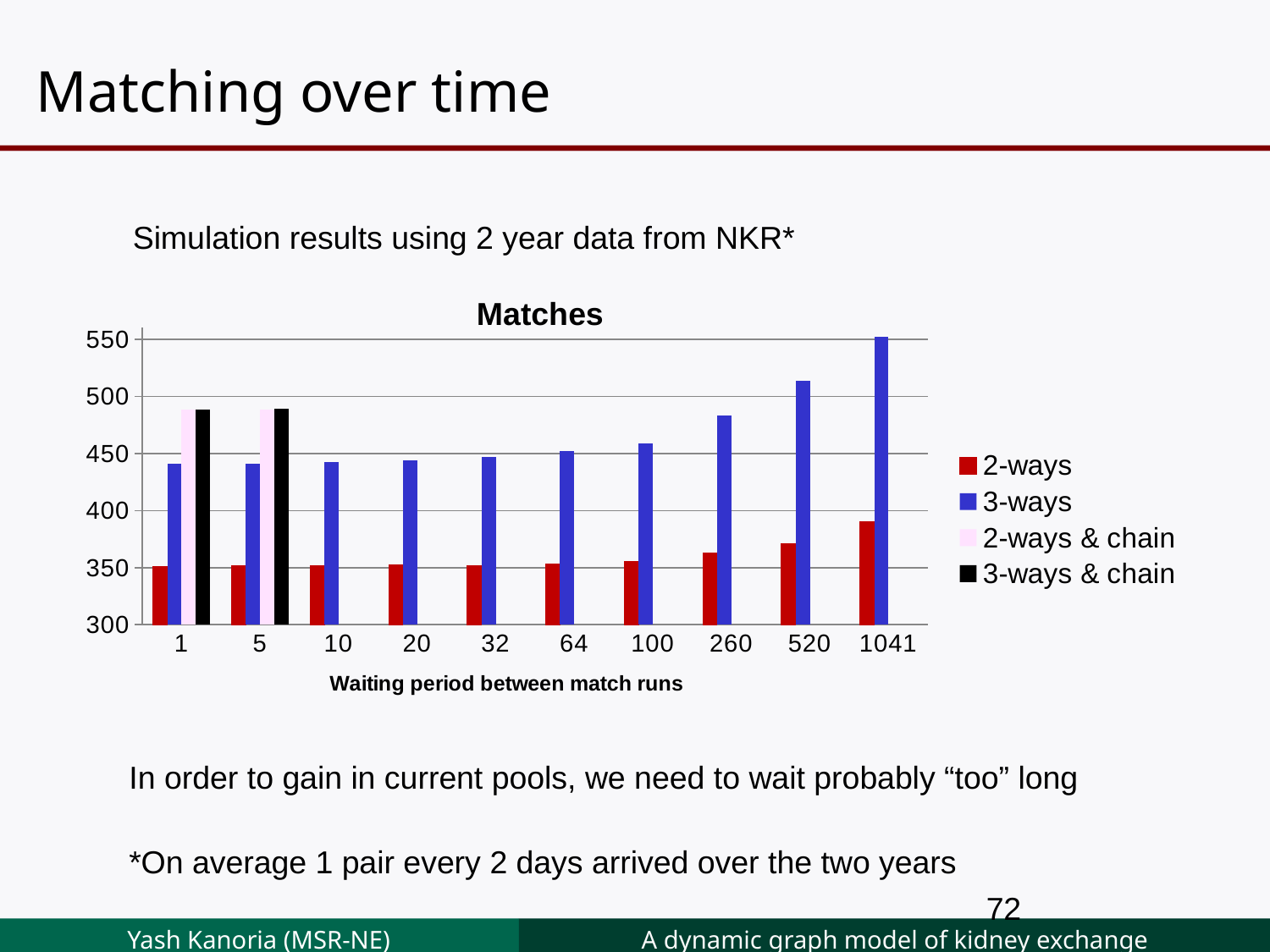
For which waiting period is the 3-ways value highest? 1041 Do the 3-ways values rise or fall as the waiting period increases along the x axis? rise How many series does the legend of the Matches chart list? 4 Is the 2-ways value for waiting period 1041 greater or less than 400? less How many waiting-period categories are shown on the x axis of the Matches chart? 10 Is the 3-ways value for waiting period 1041 greater or less than 500? greater What is the x-axis title of the Matches chart? Waiting period between match runs For which waiting period is the 2-ways value highest? 1041 What type of chart is shown on the slide? bar chart Is the 3-ways value for waiting period 260 greater or less than 500? less At waiting period 1041, which is larger: the 2-ways value or the 3-ways value? 3-ways What is the title of the chart? Matches